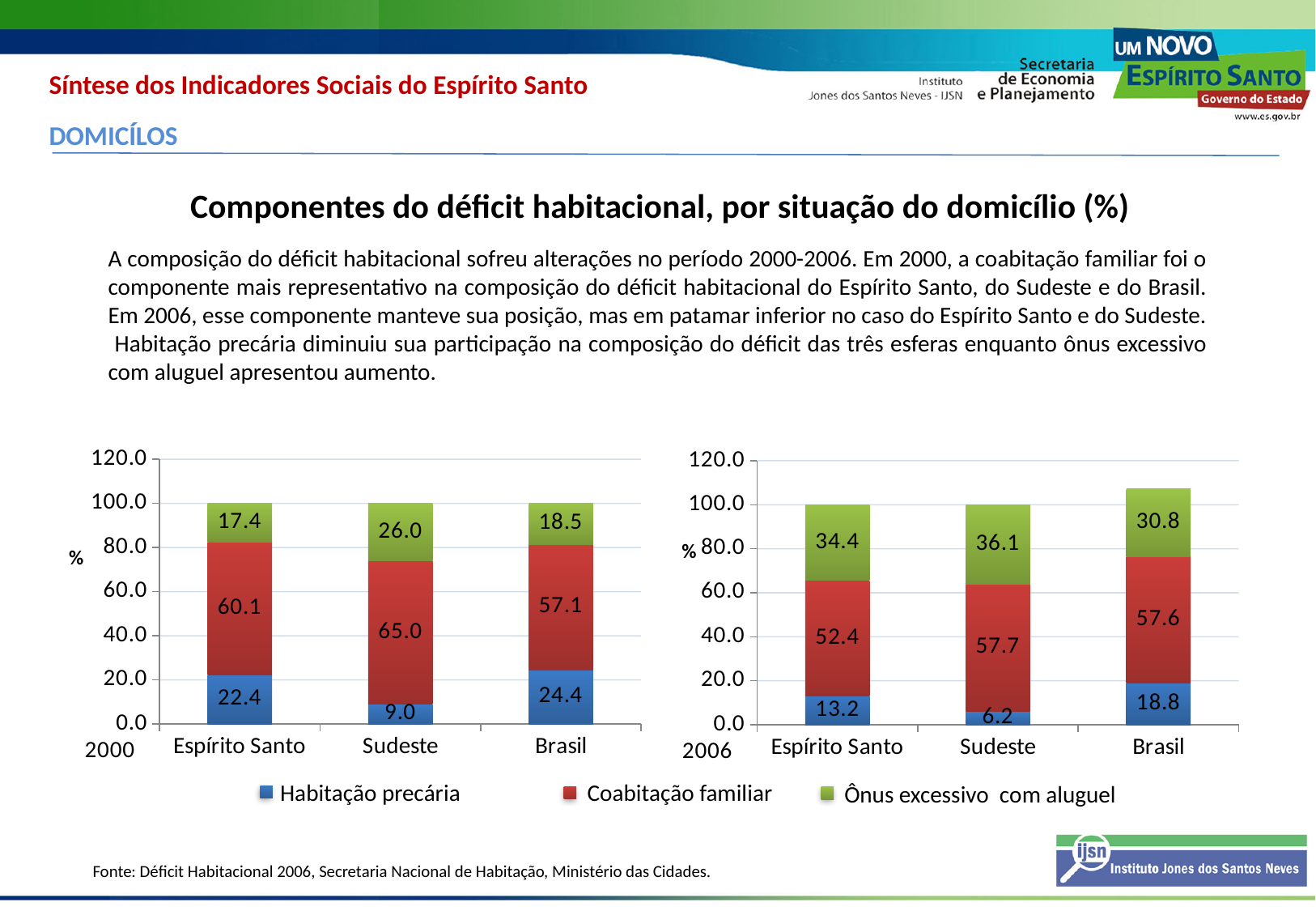
In the 2000 chart (left), what is the value of Coabitação familiar for Sudeste? 65.0 What kind of chart is the 2000 chart (left)? Stacked bar chart How many series does the legend list? 3 In the 2006 chart (right), which is larger: Habitação precária for Brasil or for Sudeste? Brasil How many categories are shown on the x axis of the 2006 chart (right)? 3 In the 2006 chart (right), what is the value of Habitação precária for Espírito Santo? 13.2 In the 2006 chart (right), what is the total of the stacked bar for Brasil? 107.2 In the 2006 chart (right), what is the value of Ônus excessivo com aluguel for Brasil? 30.8 In the 2006 chart (right), which category has the highest value for Ônus excessivo com aluguel? Sudeste In the 2000 chart (left), what is the difference between the Coabitação familiar values for Sudeste and Brasil? 7.9 In the 2000 chart (left), what is the total of the stacked bar for Brasil? 100.0 In the 2000 chart (left), which category has the lowest value for Habitação precária? Sudeste